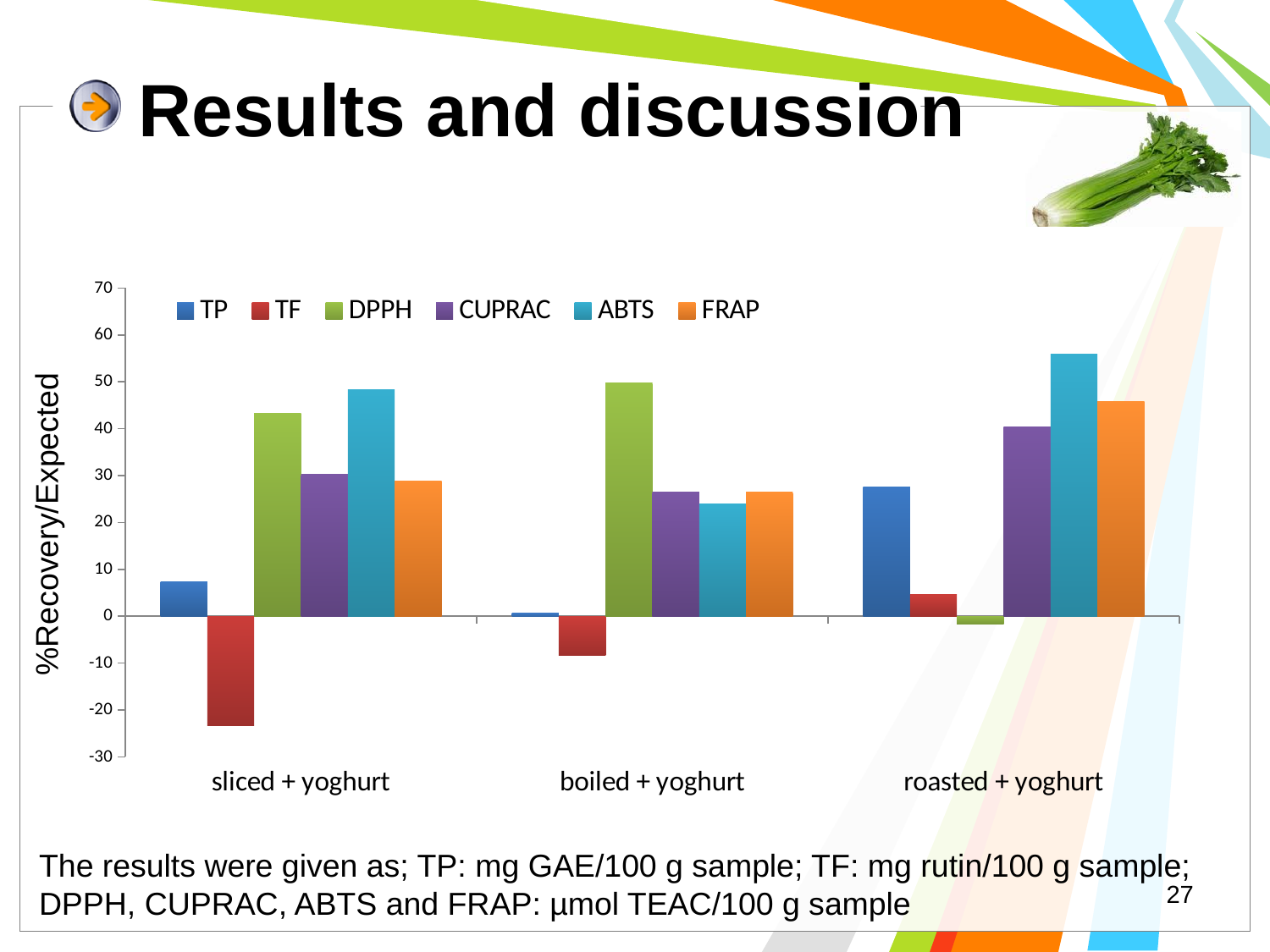
Is the value for ABTS in roasted + yoghurt greater or less than 50? greater Which series has the highest value for roasted + yoghurt? ABTS How many categories are shown on the x axis? 3 Is the value for TF in sliced + yoghurt greater or less than -20? less How many series does the legend list? 6 What is the title of the y axis? %Recovery/Expected Which is larger, the TP value for roasted + yoghurt or the TP value for sliced + yoghurt? roasted + yoghurt Which series has the lowest value for sliced + yoghurt? TF Which series has the highest value for boiled + yoghurt? DPPH Which category has the highest DPPH value? boiled + yoghurt What kind of chart is shown on the slide? bar chart Is the value for CUPRAC in sliced + yoghurt greater or less than 40? less